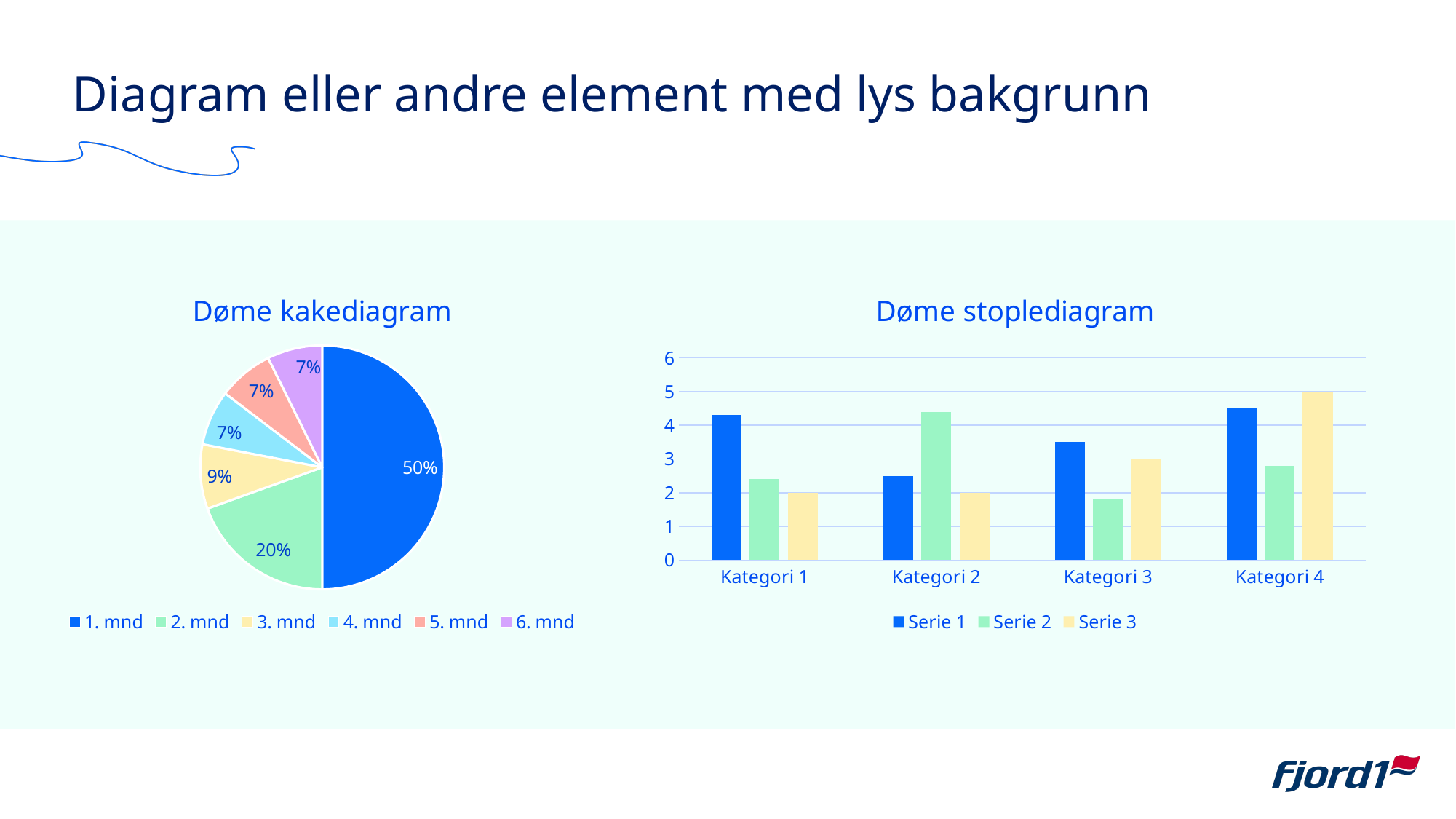
In the chart titled "Døme stoplediagram", how many series does the legend list? 3 In the chart titled "Døme kakediagram", what share of the pie does 2. mnd have? 20% In the chart titled "Døme kakediagram", what is the difference between the shares of 1. mnd and 2. mnd? 30% In the chart titled "Døme kakediagram", what share of the pie does 3. mnd have? 9% In the chart titled "Døme stoplediagram", is the value for Serie 1 in Kategori 1 greater or less than 4? greater What kind of chart is the chart titled "Døme stoplediagram"? Bar chart In the chart titled "Døme stoplediagram", which series has the tallest bar in Kategori 2? Serie 2 In the chart titled "Døme stoplediagram", how many categories are shown on the x axis? 4 In the chart titled "Døme kakediagram", how many slices does the pie have? 6 In the chart titled "Døme kakediagram", which category has the largest slice? 1. mnd In the chart titled "Døme stoplediagram", is the value for Serie 2 in Kategori 3 greater or less than 2? less In the chart titled "Døme kakediagram", what share of the pie does 1. mnd have? 50%